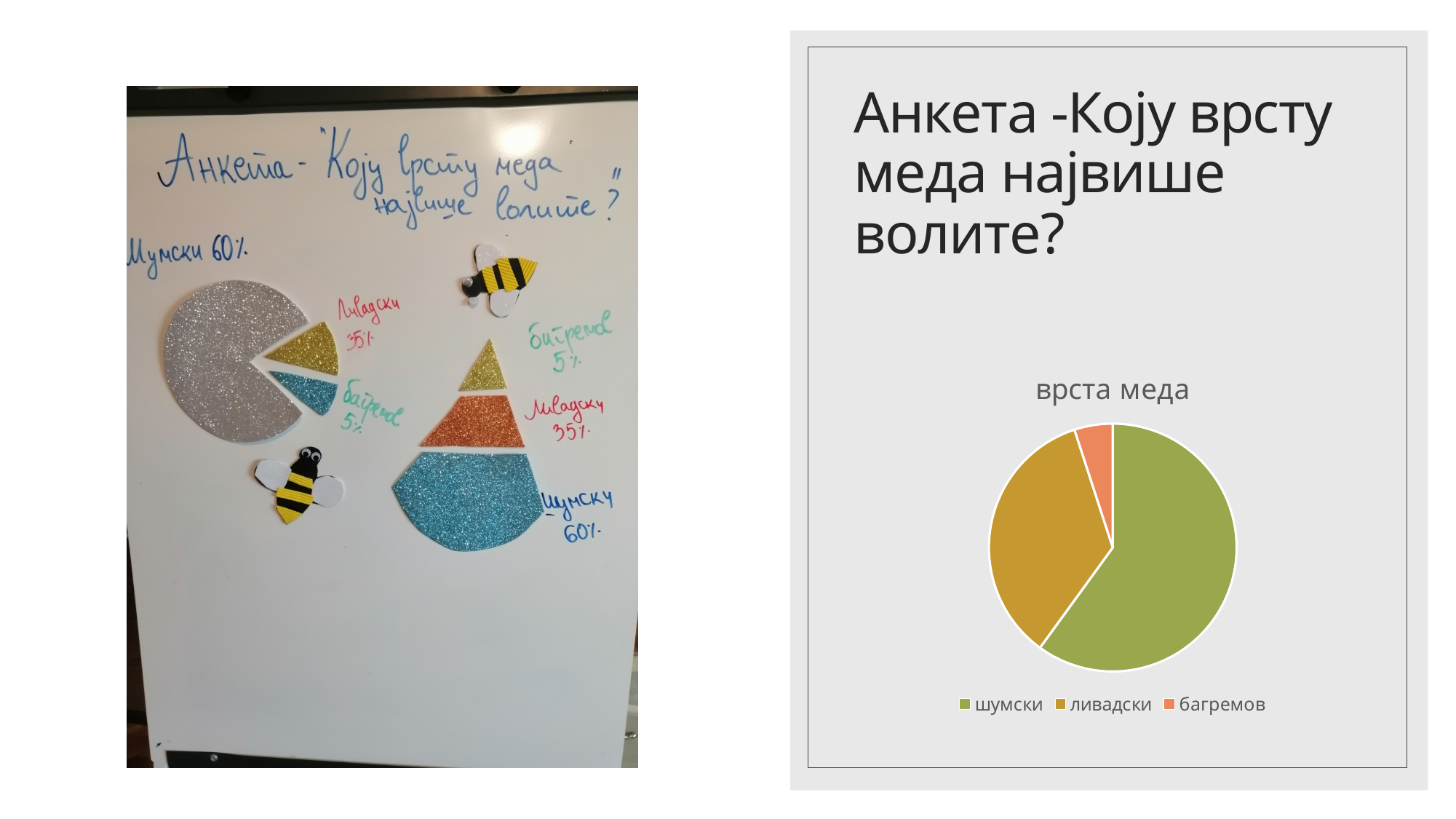
What kind of chart is shown on the right side of the slide? pie chart In the pie chart titled 'врста меда', which slice is larger: ливадски or багремов? ливадски In the pie chart titled 'врста меда', what colour is the slice for багремов? orange In the pie chart titled 'врста меда', which slice is larger: шумски or ливадски? шумски How many slices does the pie chart titled 'врста меда' have? 3 In the pie chart titled 'врста меда', which category has the largest slice? шумски In the pie chart titled 'врста меда', which category has the smallest slice? багремов What is the title of the pie chart on the right side of the slide? врста меда How many entries does the legend of the pie chart titled 'врста меда' list? 3